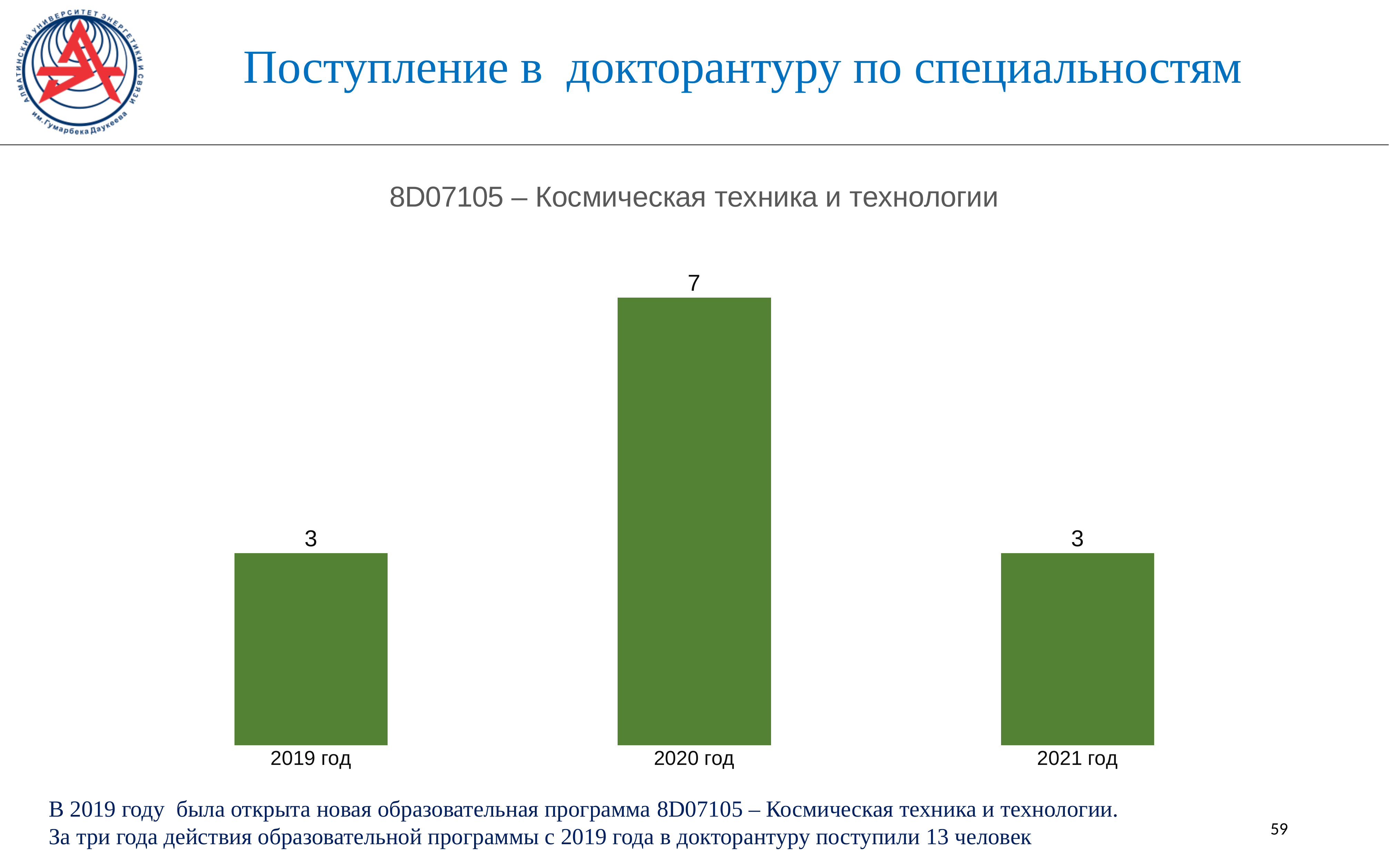
What is the title of the chart? 8D07105 – Космическая техника и технологии What is the difference between the values for 2020 год and 2019 год? 4 What colour are the bars in the chart? green What is the value for 2021 год? 3 What is the total of the values across all three years? 13 How many categories are shown on the chart? 3 What kind of chart is shown on the slide? bar chart Which is larger, the value for 2020 год or the value for 2021 год? 2020 год Does the value rise or fall from 2020 год to 2021 год? fall What is the value for 2019 год? 3 What is the value for 2020 год? 7 Which year has the highest value? 2020 год